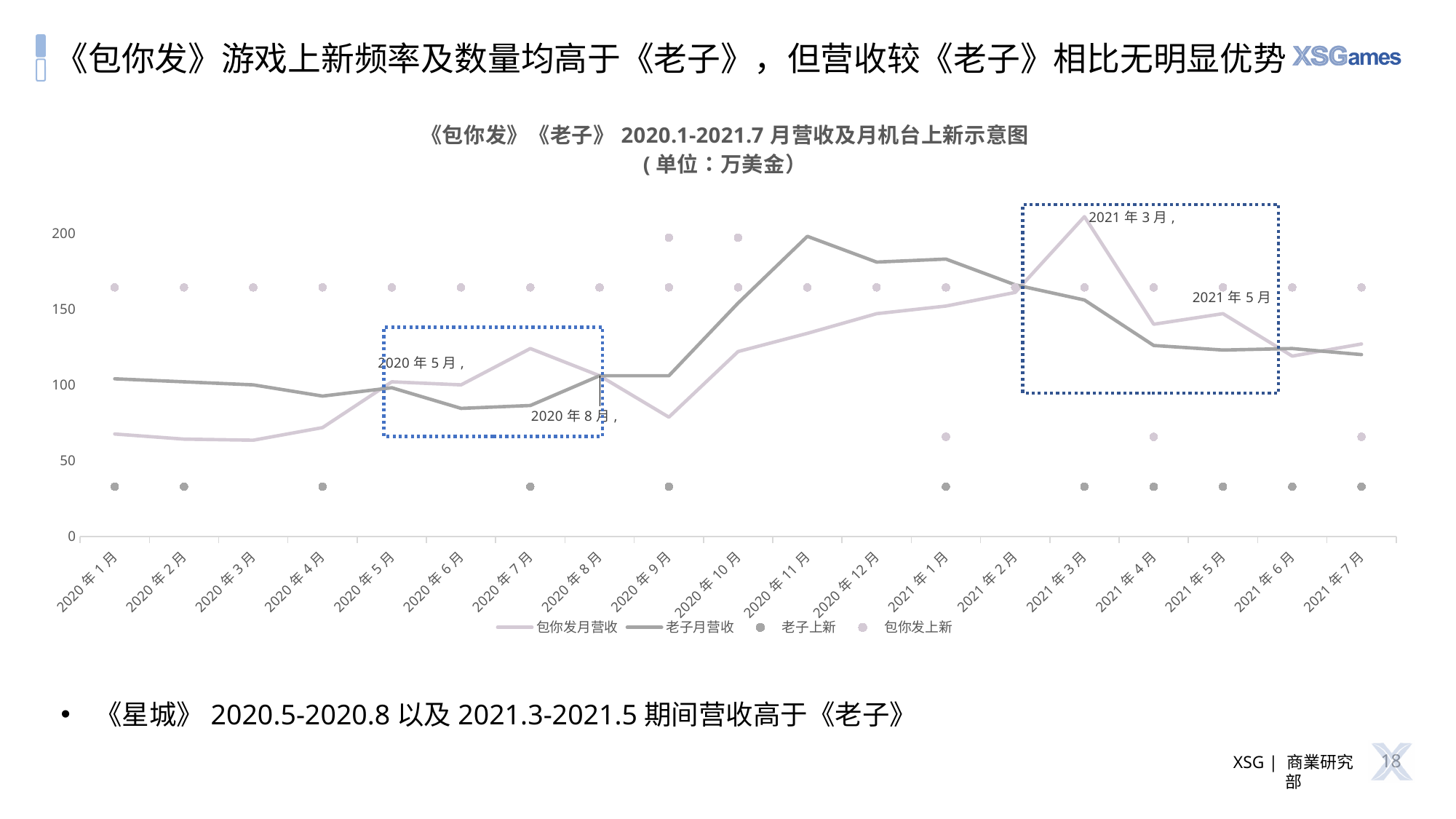
In which month does 包你发月营收 reach its highest value? 2021年3月 What kind of chart is shown on the slide? line chart What unit is stated in the chart title? 万美金 How many months are shown along the x axis? 19 In which month does 老子月营收 reach its highest value? 2020年11月 How many series does the legend list? 4 Is the value of 包你发月营收 in 2021年3月 greater or less than 200? greater Is the value of 老子月营收 in 2020年11月 greater or less than 150? greater Is the value of 包你发月营收 in 2020年1月 greater or less than 100? less Does 老子月营收 rise or fall from 2020年9月 to 2020年11月? rise In 2021年3月, which is larger: 包你发月营收 or 老子月营收? 包你发月营收